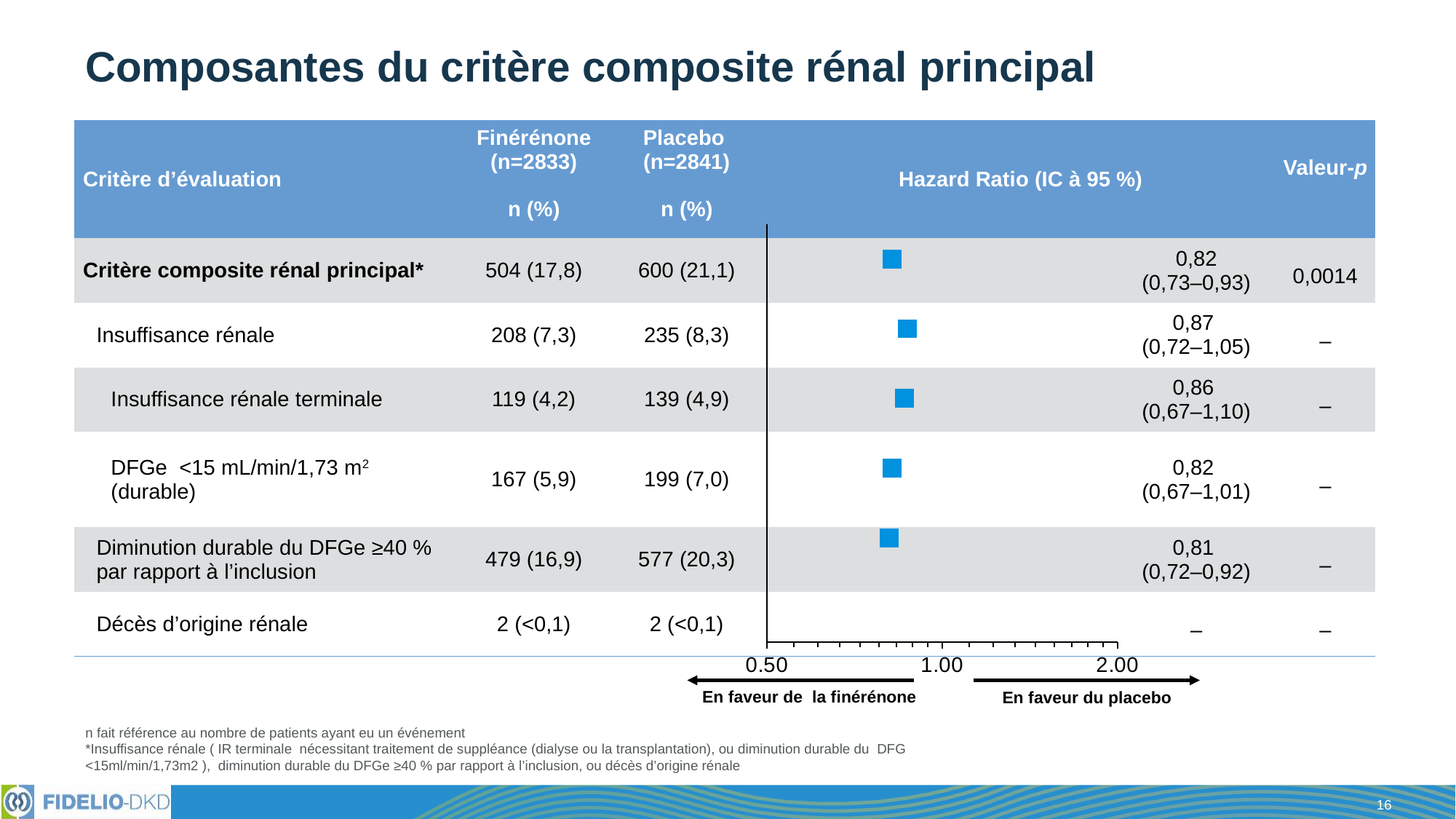
What is the hazard ratio for Diminution durable du DFGe ≥40 % par rapport à l'inclusion? 0,81 What is the 95% confidence interval of the hazard ratio for Insuffisance rénale? 0,72–1,05 What does the left arrow below the hazard ratio axis indicate? En faveur de la finérénone Which endpoint has the lowest hazard ratio plotted? Diminution durable du DFGe ≥40 % par rapport à l'inclusion Which endpoint has the highest hazard ratio plotted? Insuffisance rénale Is the hazard ratio for DFGe <15 mL/min/1,73 m² (durable) greater or less than 1.00? less What is the hazard ratio for Critère composite rénal principal*? 0,82 What kind of chart is shown in the Hazard Ratio column of the table? Forest plot What is the p-value shown for Critère composite rénal principal*? 0,0014 How many hazard ratio points are plotted in the forest plot? 5 What is the hazard ratio for Insuffisance rénale terminale? 0,86 What is the difference between the hazard ratio for Insuffisance rénale and the hazard ratio for Diminution durable du DFGe ≥40 % par rapport à l'inclusion? 0,06